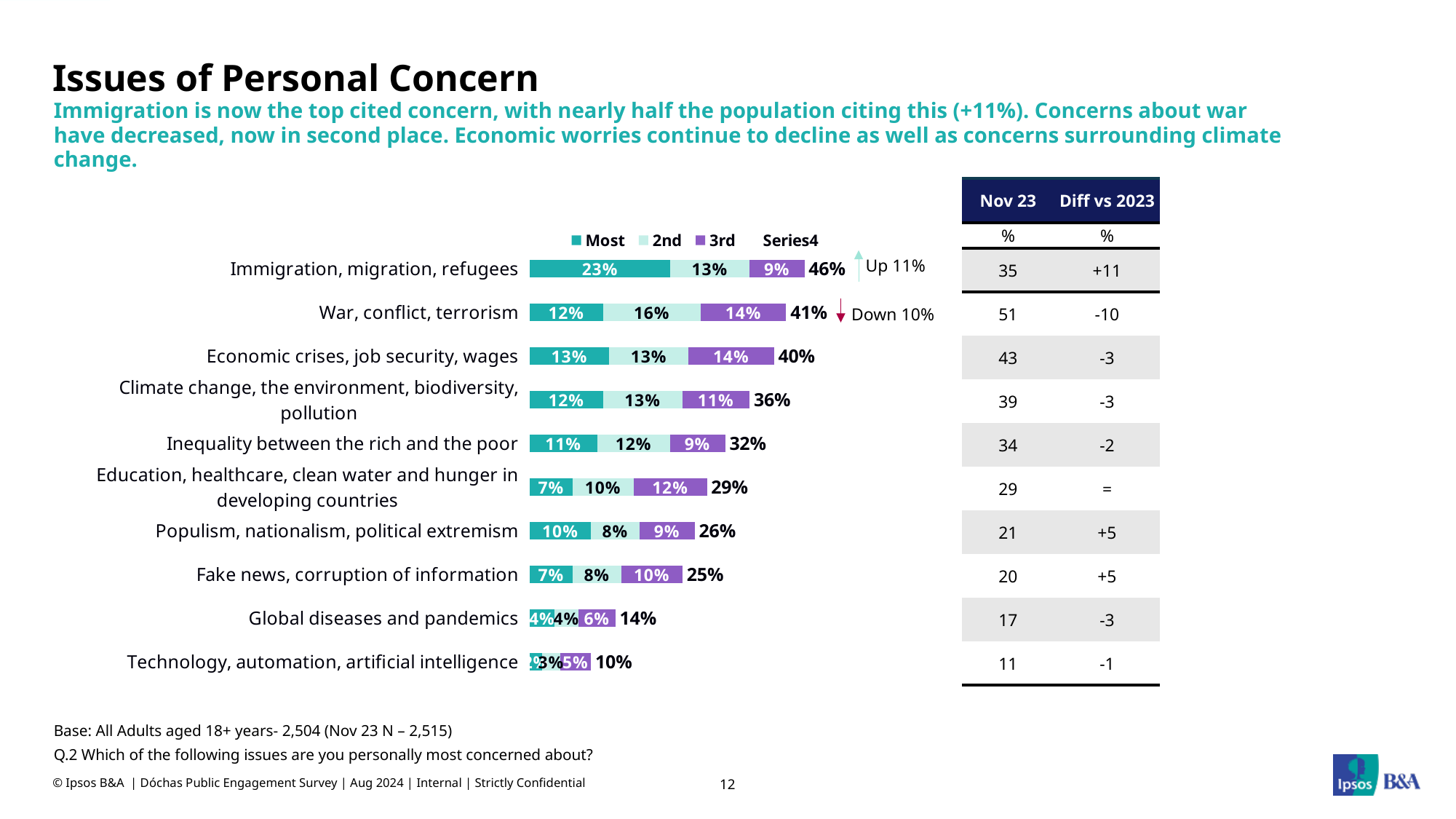
What is the total of the stacked bar for Climate change, the environment, biodiversity, pollution? 36% Which has the larger "Most" value: Economic crises, job security, wages or War, conflict, terrorism? Economic crises, job security, wages Which category has the lowest total in the bar chart? Technology, automation, artificial intelligence What is the "Most" value for Immigration, migration, refugees? 23% What is the "3rd" value for Fake news, corruption of information? 10% Which category has the highest total in the bar chart? Immigration, migration, refugees What kind of chart is shown on the slide? Stacked bar chart What is the difference between the total for Immigration, migration, refugees and the total for War, conflict, terrorism? 5 percentage points What is the "2nd" value for War, conflict, terrorism? 16% How many categories are shown in the bar chart? 10 What is the "3rd" value for Economic crises, job security, wages? 14% How many series does the chart legend list? 4